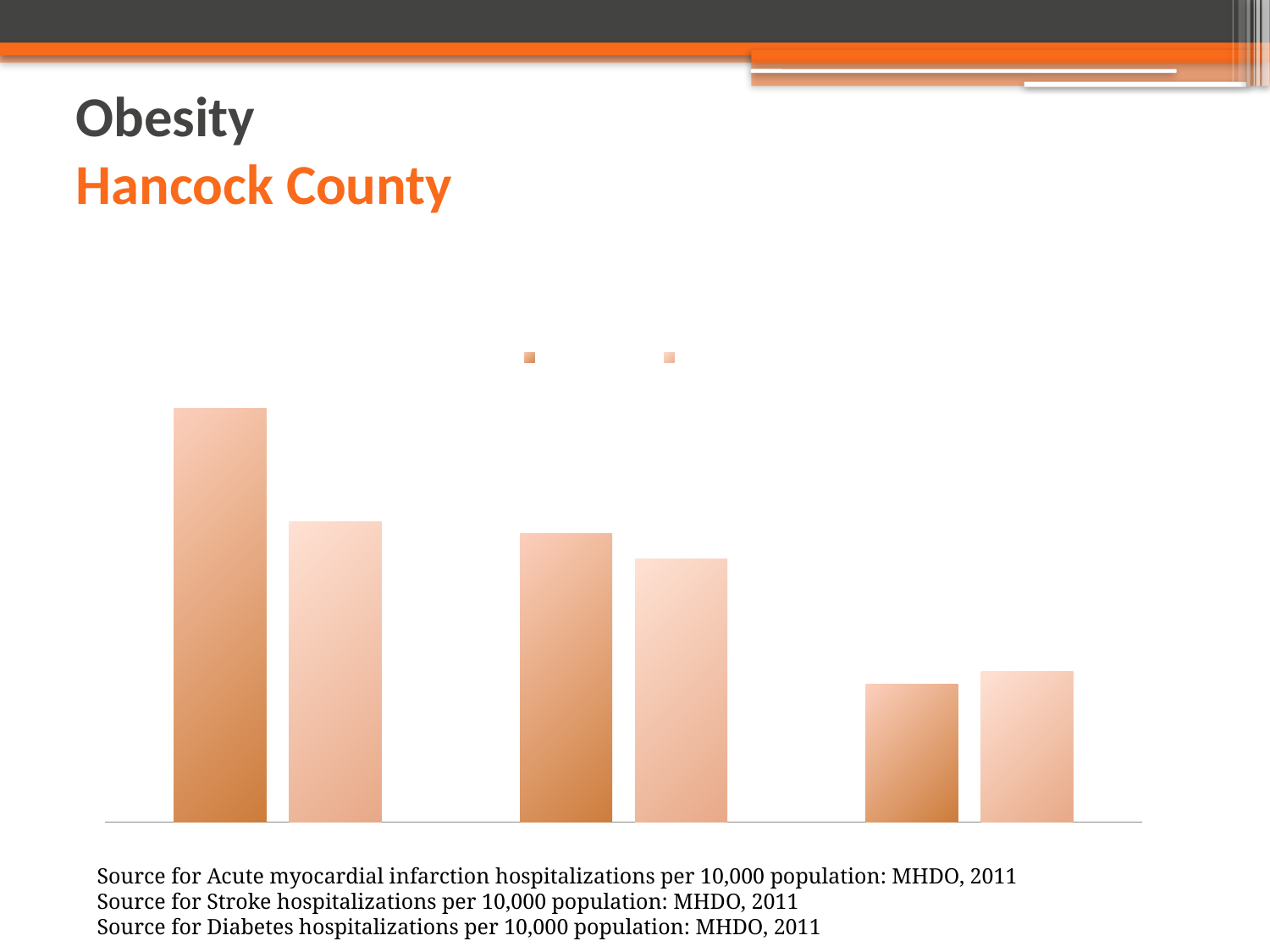
How many bars are plotted on the chart in total? 6 Which group of bars contains the shortest bar on the chart: the leftmost, middle, or rightmost? rightmost Which group of bars contains the tallest bar on the chart: the leftmost, middle, or rightmost? leftmost What colour are the bars on the chart? orange Are the bars on the chart vertical or horizontal? vertical Do the bar heights rise or fall from left to right across the chart? fall In the rightmost group of bars, is the darker orange bar or the lighter orange bar taller? the lighter orange bar How many groups of bars are plotted on the chart? 3 How many series does the chart's legend list? 2 In the leftmost group of bars, is the darker orange bar or the lighter orange bar taller? the darker orange bar What kind of chart is shown on the slide? bar chart